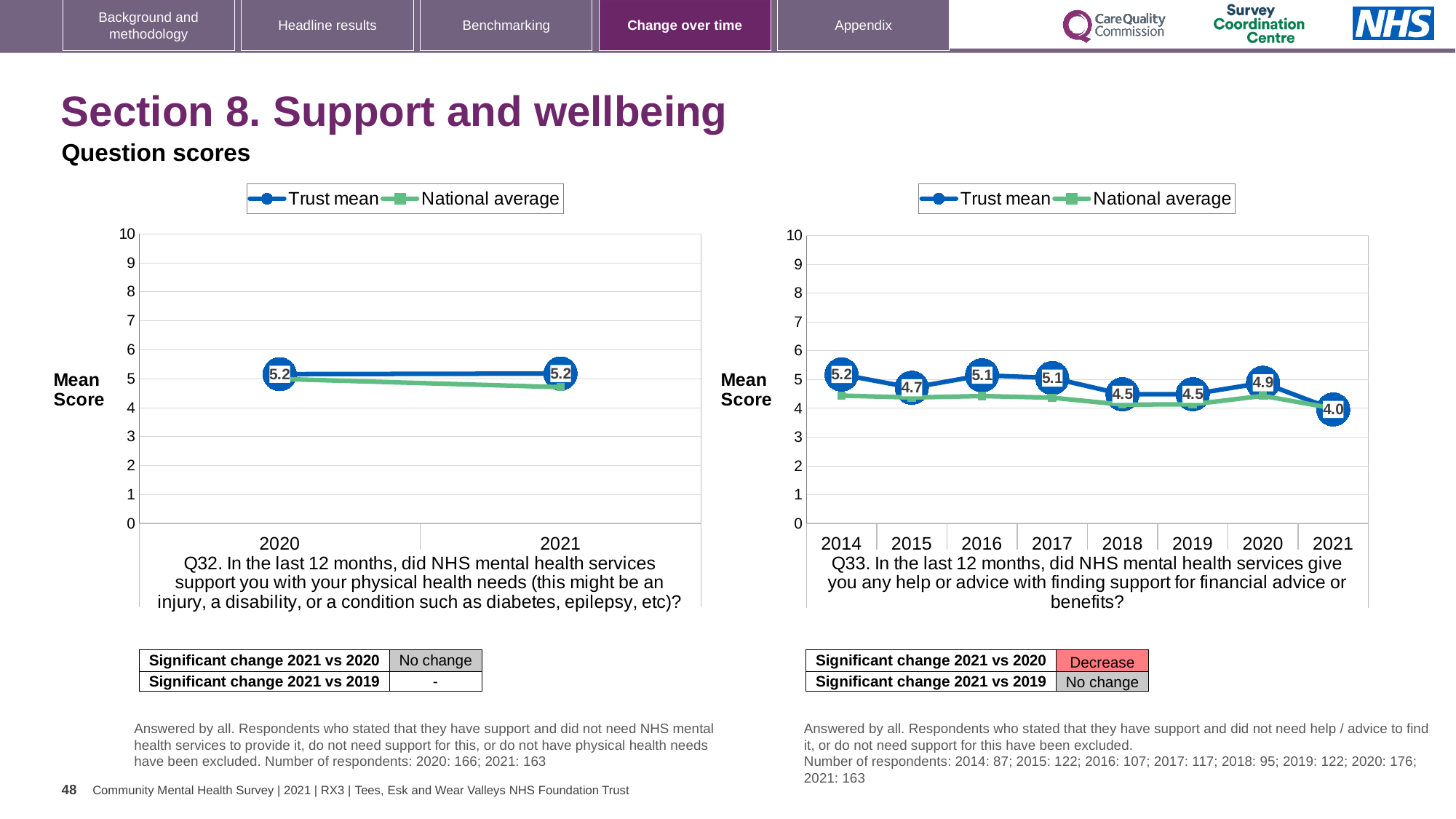
In the Q33 chart on the right, what is the Trust mean for 2015? 4.7 In the Q33 chart on the right, which year has the lowest Trust mean? 2021 What type of chart is the Q33 chart on the right? Line chart How many series does the legend of the Q32 chart on the left list? 2 In the Q32 chart on the left, what is the Trust mean for 2021? 5.2 In the Q33 chart on the right, does the Trust mean rise or fall from 2020 to 2021? Fall In the Q33 chart on the right, is the National average for 2021 greater or less than 5? less In the Q33 chart on the right, which year has the highest Trust mean? 2014 In the Q33 chart on the right, what is the difference between the Trust mean in 2020 and in 2021? 0.9 How many years are shown on the x axis of the Q33 chart on the right? 8 In the Q33 chart on the right, is the Trust mean higher in 2016 or in 2018? 2016 In the Q33 chart on the right, what is the Trust mean for 2021? 4.0